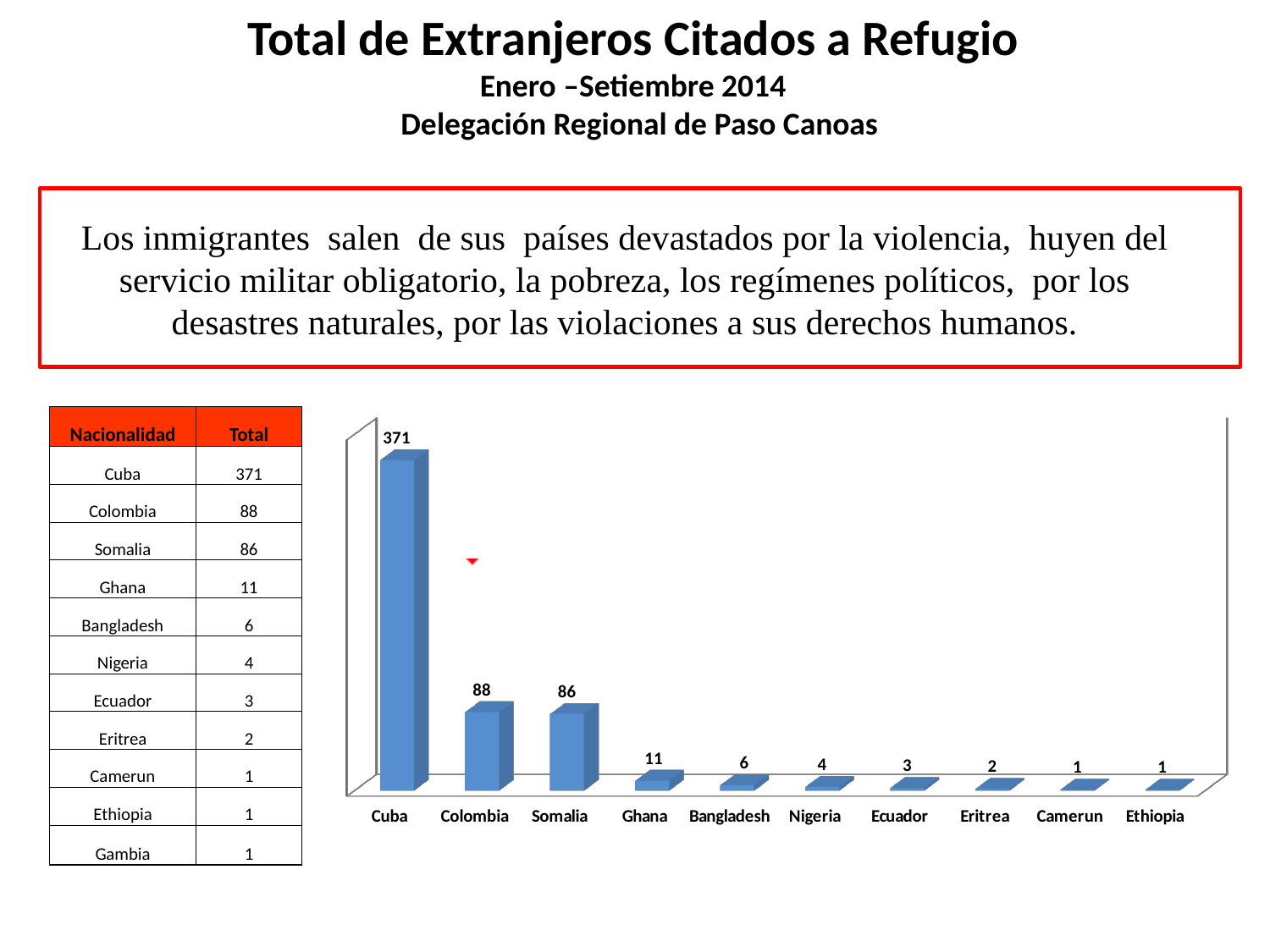
What is the difference between the values for Colombia and Somalia in the bar chart? 2 What is the value for Ghana in the bar chart? 11 What kind of chart is shown on the slide? Bar chart Do the values in the bar chart generally rise or fall from left to right along the x axis? Fall What is the value for Bangladesh in the bar chart? 6 What is the difference between the values for Cuba and Colombia in the bar chart? 283 What is the value for Somalia in the bar chart? 86 What is the value for Eritrea in the bar chart? 2 What is the value for Cuba in the bar chart? 371 Which category has the highest value in the bar chart? Cuba Which is larger in the bar chart, the value for Ghana or the value for Nigeria? Ghana How many categories are shown on the x axis of the bar chart? 10